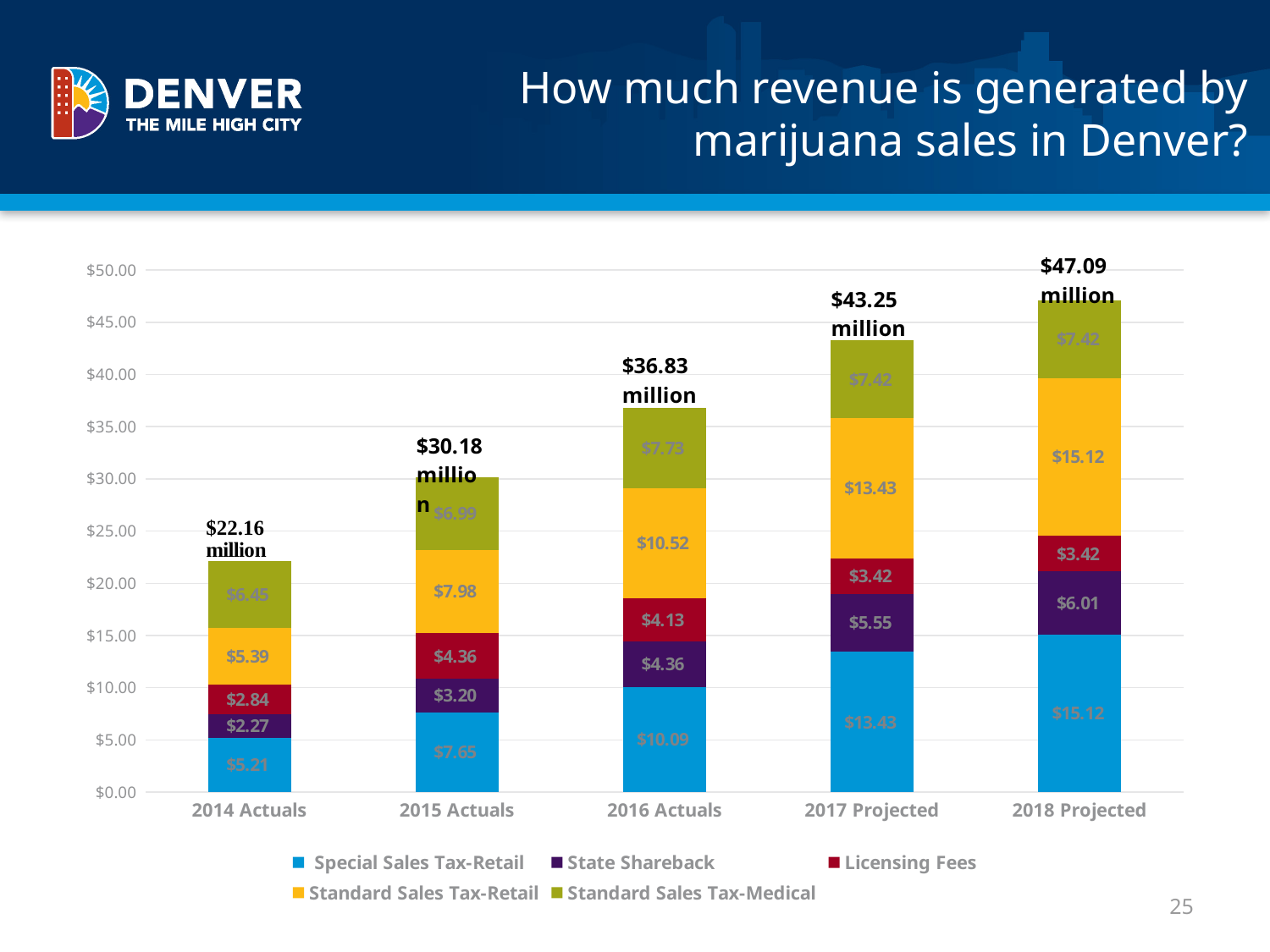
What is the value for State Shareback in 2014 Actuals? $2.27 What is the value for Standard Sales Tax-Retail in 2016 Actuals? $10.52 How many series does the legend list? 5 What is the value for Special Sales Tax-Retail in 2018 Projected? $15.12 What is the total revenue shown for 2017 Projected? $43.25 million What is the total revenue shown for 2014 Actuals? $22.16 million What is the difference between Standard Sales Tax-Medical in 2016 Actuals and in 2017 Projected? $0.31 Which is larger in 2015 Actuals: Standard Sales Tax-Retail or Standard Sales Tax-Medical? Standard Sales Tax-Retail Which year has the lowest total revenue? 2014 Actuals Do the total revenues rise or fall from 2014 Actuals to 2018 Projected? Rise What is the value for Licensing Fees in 2015 Actuals? $4.36 Which year has the highest total revenue? 2018 Projected